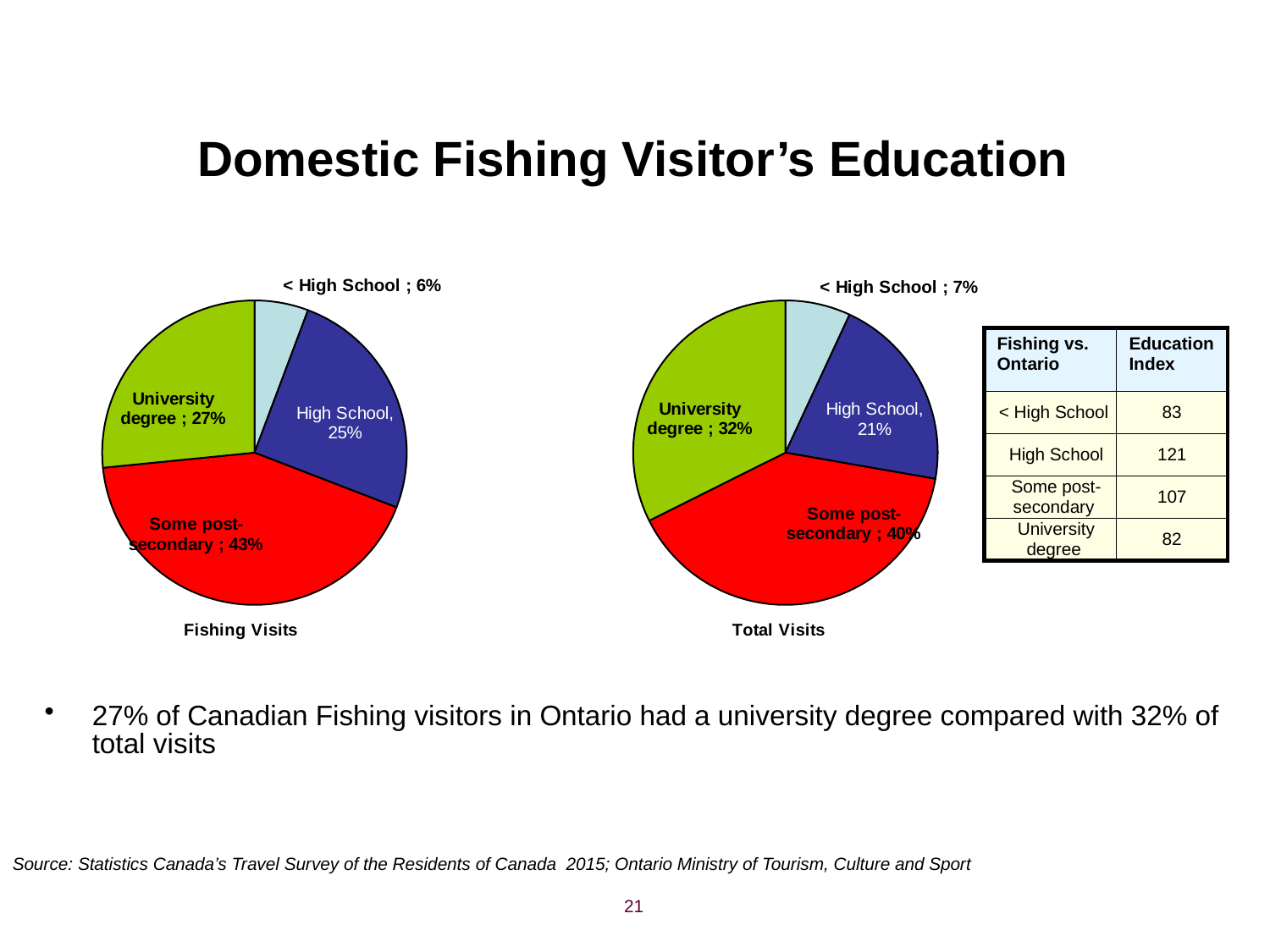
What is the difference between the High School share in the Fishing Visits chart and the High School share in the Total Visits chart? 4% In the Total Visits pie chart, what is the share for Some post-secondary? 40% What type of chart is used for Total Visits? Pie chart What colour is the Some post-secondary slice in the Fishing Visits pie chart? Red In the Fishing Visits pie chart, which education category has the largest share? Some post-secondary How many slices does the Fishing Visits pie chart have? 4 What is the difference between the Some post-secondary share and the University degree share in the Fishing Visits chart? 16% Which is larger: the University degree share in the Fishing Visits chart or in the Total Visits chart? Total Visits In the Total Visits pie chart, what share of visits is for University degree? 32% In the Total Visits pie chart, which education category has the smallest share? < High School In the Fishing Visits pie chart, what is the share for < High School? 6% In the Fishing Visits pie chart, what share of visitors had some post-secondary education? 43%